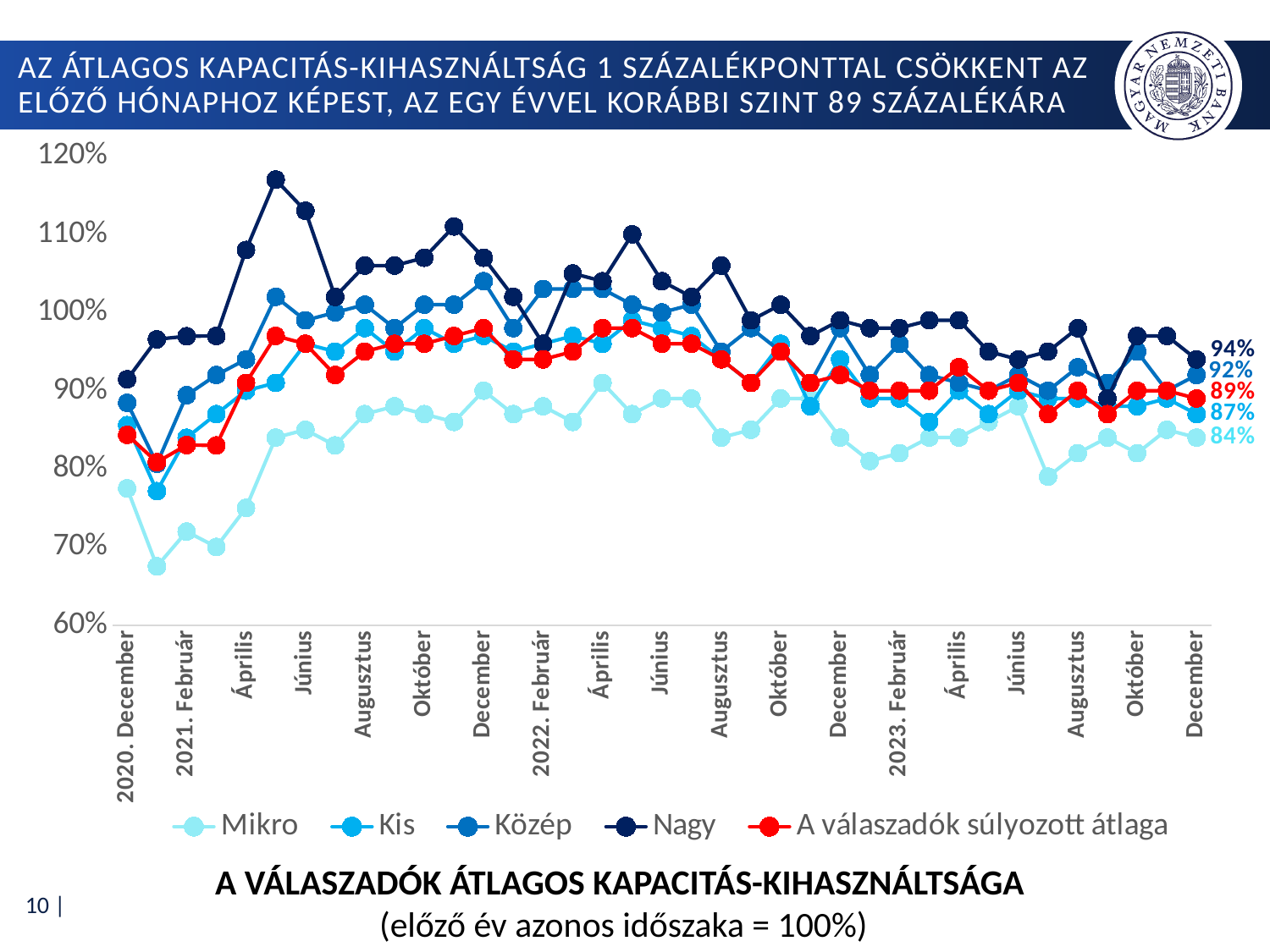
What is the value for A válaszadók súlyozott átlaga at the last point (2023 December)? 89% At the last point (2023 December), which is larger: Kis or Közép? Közép What is the value for Mikro at the last point (2023 December)? 84% What kind of chart is shown on the slide? Line chart How many series does the legend list? 5 Which series has the lowest value at the last point (2023 December)? Mikro What is the value for Nagy at the last point (2023 December)? 94% Is the peak value of the Nagy series in 2021 greater or less than 110%? greater Which colour is used for the series A válaszadók súlyozott átlaga? Red What is the difference between the Nagy and Mikro values at the last point (2023 December)? 10 percentage points Which series has the highest value at the last point (2023 December)? Nagy What is the value for Közép at the last point (2023 December)? 92%